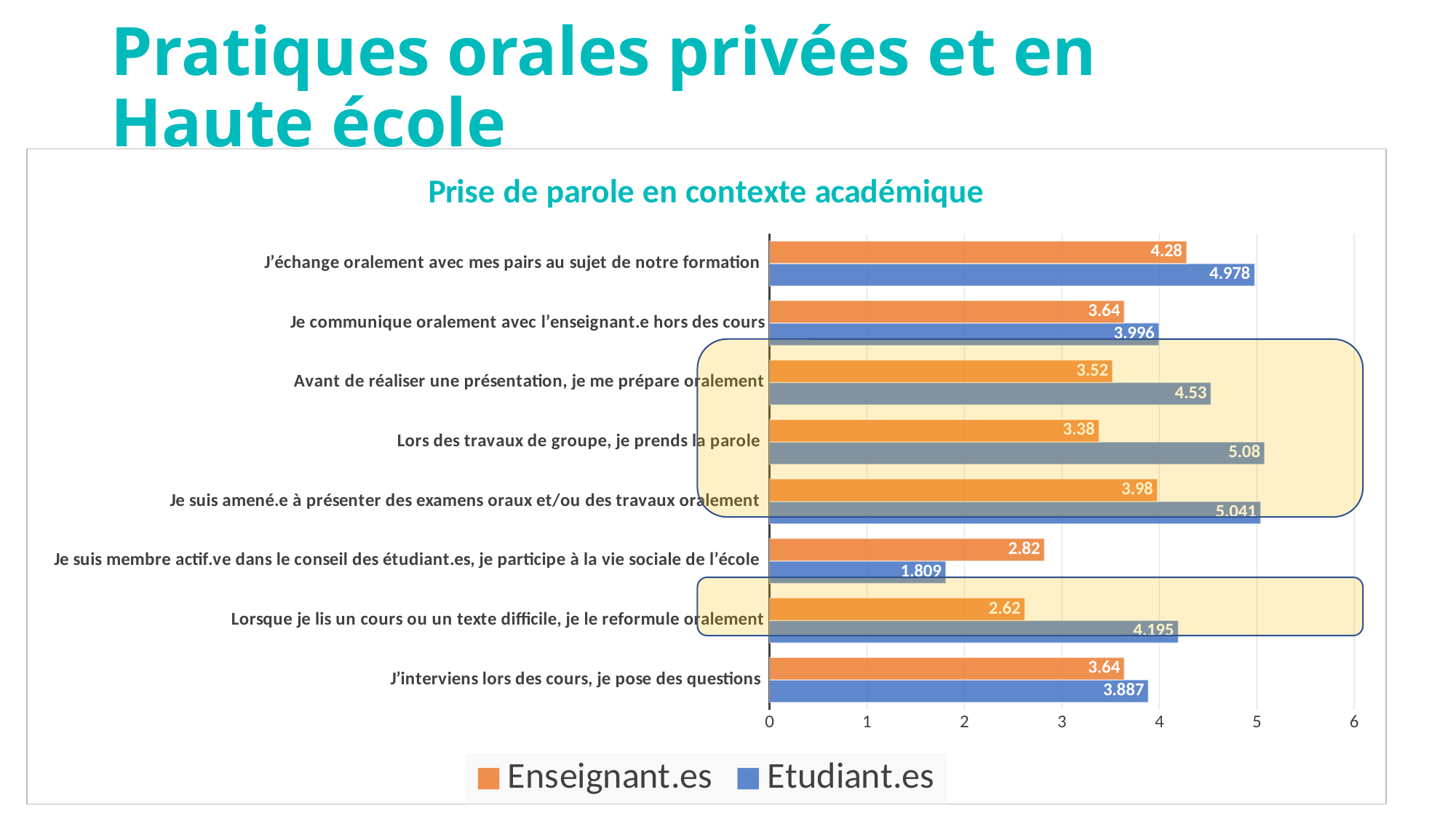
What is the Etudiant.es value for "Lors des travaux de groupe, je prends la parole"? 5.08 What is the difference between the Etudiant.es and Enseignant.es values for "Lors des travaux de groupe, je prends la parole"? 1.7 How many series does the legend list? 2 How many categories are plotted in the chart? 8 What is the title of the chart? Prise de parole en contexte académique What type of chart is shown on the slide? Bar chart What is the Etudiant.es value for "Je suis membre actif.ve dans le conseil des étudiant.es, je participe à la vie sociale de l'école"? 1.809 For "Je suis membre actif.ve dans le conseil des étudiant.es, je participe à la vie sociale de l'école", which series has the larger value, Enseignant.es or Etudiant.es? Enseignant.es Which category has the highest Enseignant.es value? J'échange oralement avec mes pairs au sujet de notre formation Which category has the lowest Etudiant.es value? Je suis membre actif.ve dans le conseil des étudiant.es, je participe à la vie sociale de l'école What is the Enseignant.es value for "Lorsque je lis un cours ou un texte difficile, je le reformule oralement"? 2.62 Is the Etudiant.es value for "Avant de réaliser une présentation, je me prépare oralement" greater or less than 4? greater